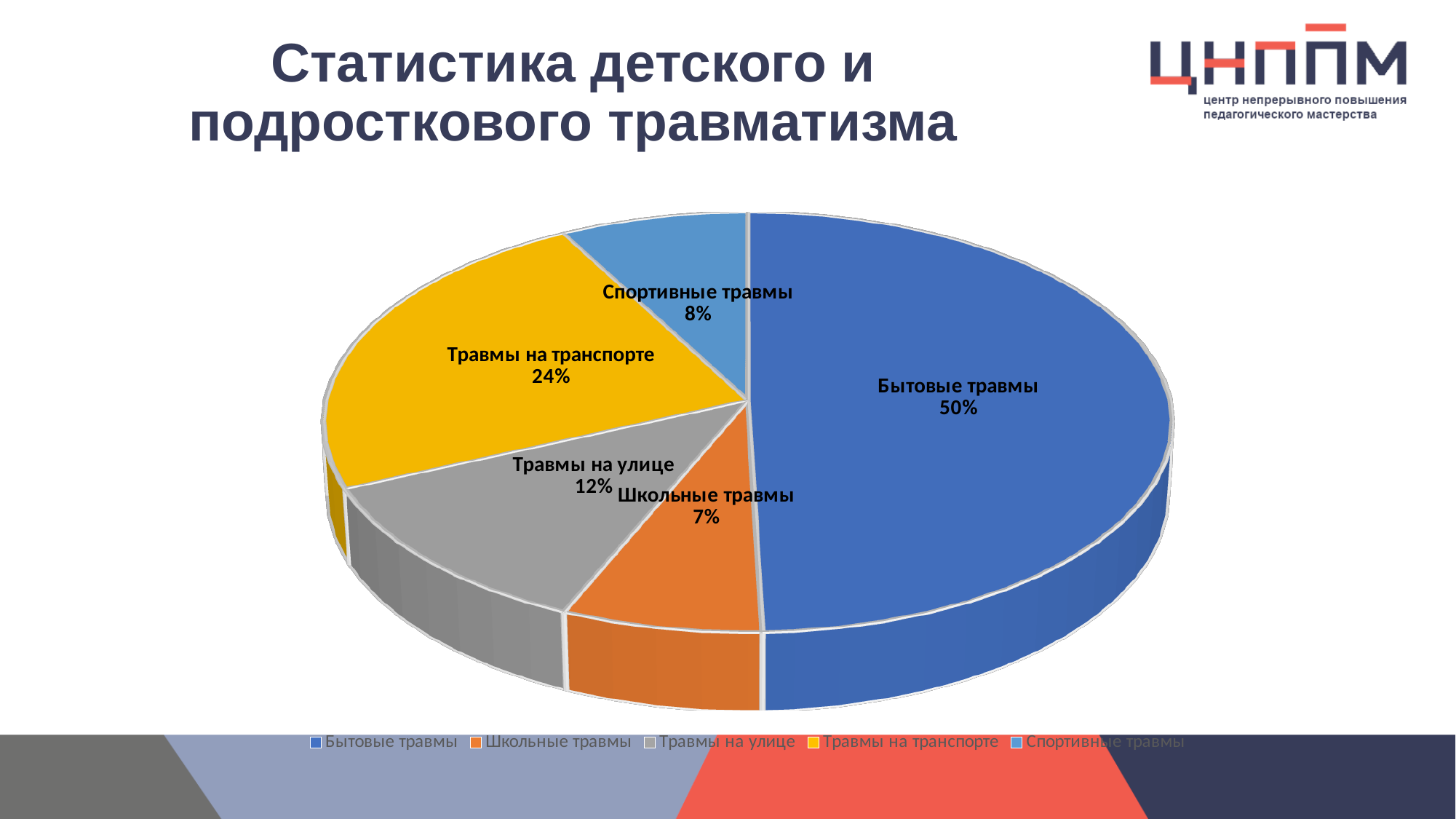
What share of the pie is Травмы на транспорте? 24% What is the difference in percentage points between Бытовые травмы and Травмы на транспорте? 26 What kind of chart is shown on the slide? Pie chart What share of the pie is Травмы на улице? 12% What colour is the slice for Травмы на транспорте? Yellow How many categories does the pie chart show? 5 What share of the pie is Школьные травмы? 7% Which is larger, Травмы на улице or Спортивные травмы? Травмы на улице Which category has the largest slice of the pie? Бытовые травмы Which category has the smallest slice of the pie? Школьные травмы